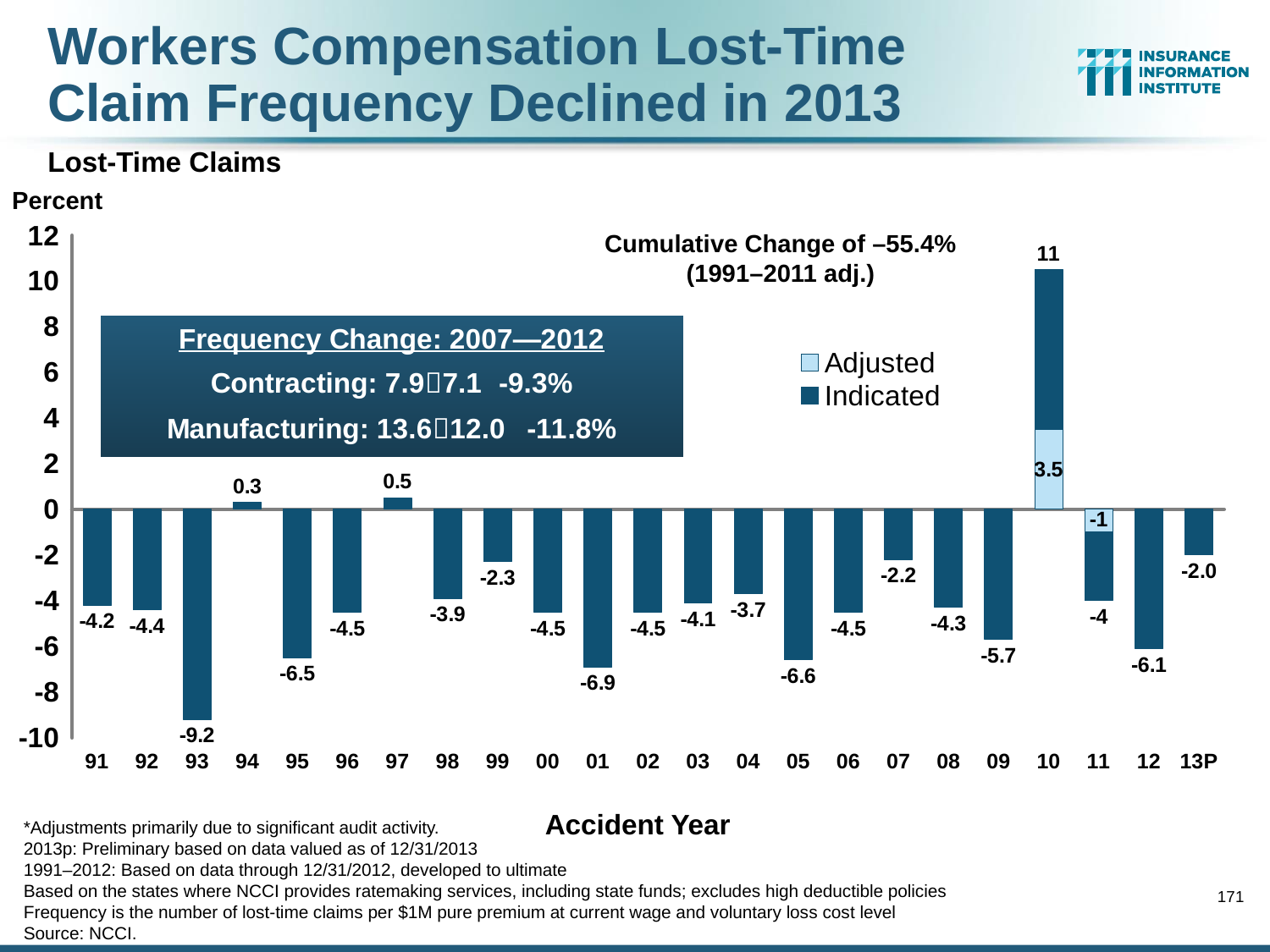
What is the Indicated value for accident year 10? 11 What is the value for accident year 13P? -2.0 What is the Adjusted value for accident year 10? 3.5 What kind of chart is shown on the slide? bar chart How many series does the legend list? 2 Which accident year has the lower value, 01 or 05? 01 What is the difference between the values for accident years 12 and 13P? 4.1 Which accident year has the lowest value? 93 How many accident years are shown on the x axis? 23 Which accident year has the highest value? 10 What cumulative change (1991–2011 adj.) is stated on the chart? –55.4% What is the value for accident year 93? -9.2